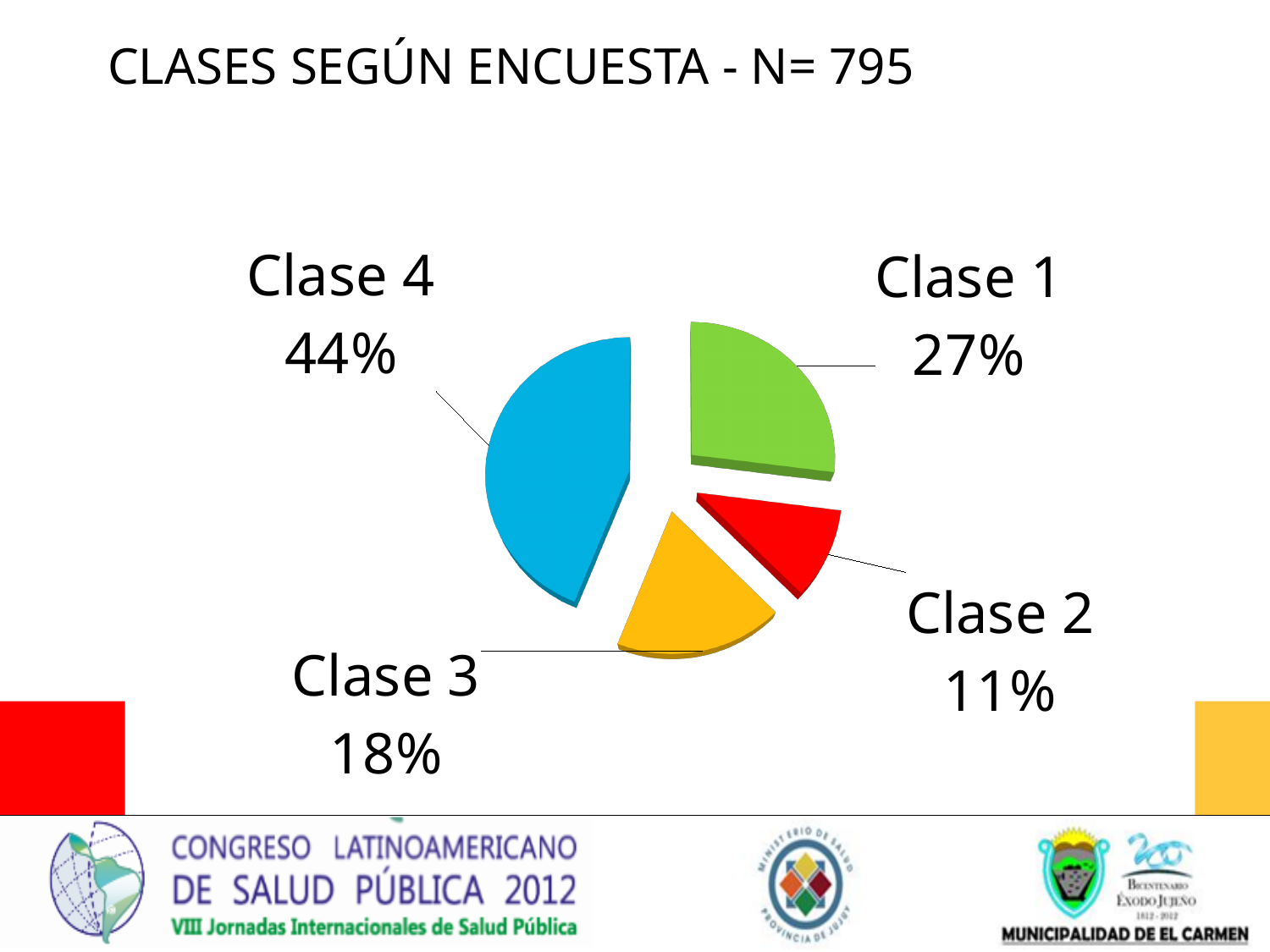
How many slices does the pie chart have? 4 Which is larger, the share for Clase 3 or the share for Clase 2? Clase 3 What percentage does Clase 3 represent? 18% What kind of chart is shown on the slide? pie chart Which class has the largest share of the pie? Clase 4 What colour is the slice for Clase 4? blue Which class has the smallest share of the pie? Clase 2 What is the title of the chart? CLASES SEGÚN ENCUESTA - N= 795 What percentage does Clase 4 represent? 44% What percentage does Clase 2 represent? 11% What is the difference in percentage points between Clase 4 and Clase 1? 17 What percentage does Clase 1 represent? 27%